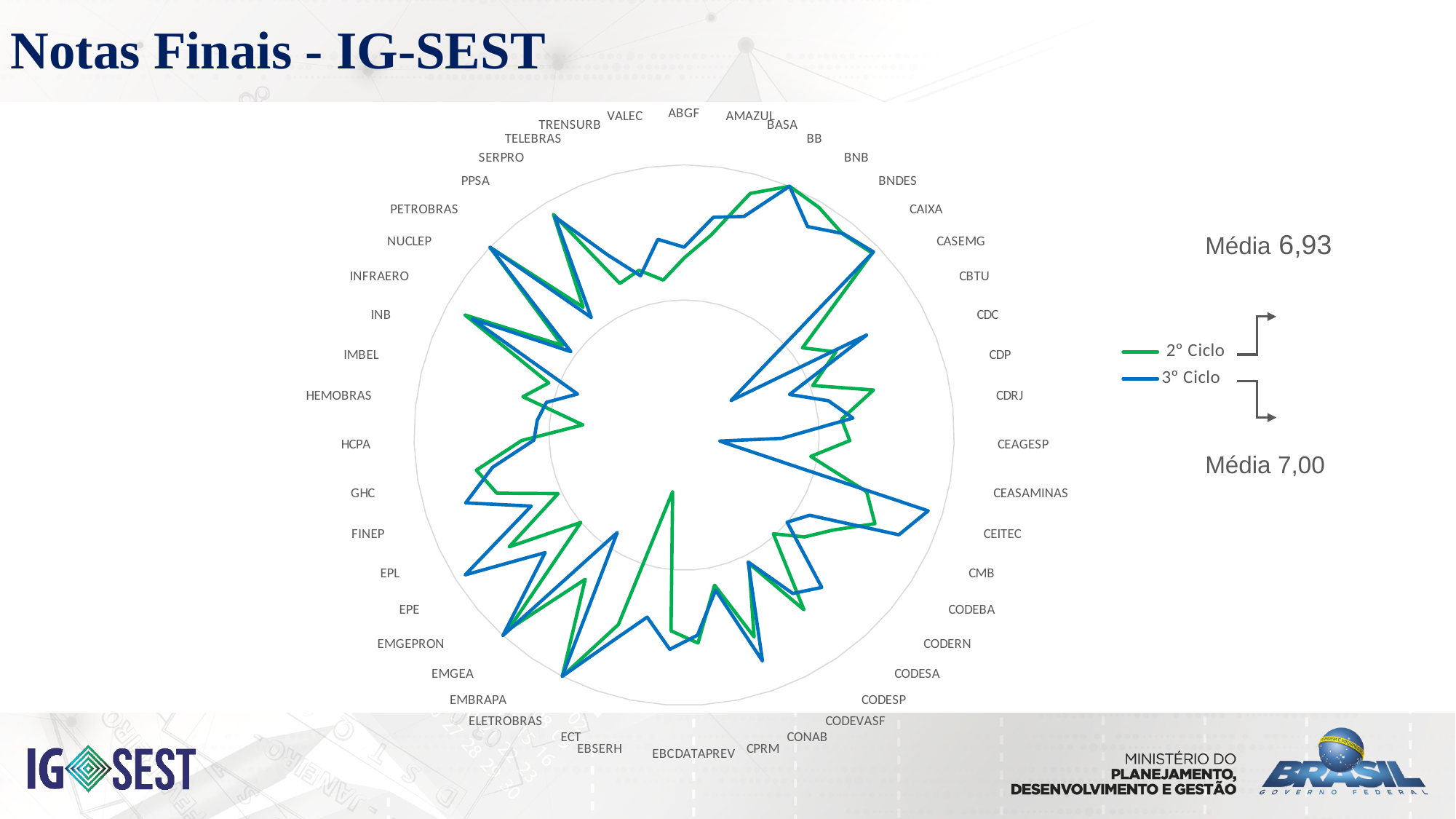
How many series does the legend of the chart list? 2 What average (Média) is shown for the 3° Ciclo series? 7,00 What kind of chart is shown on the slide? Radar chart For CBTU, which series has the larger value, 2° Ciclo or 3° Ciclo? 3° Ciclo What average (Média) is shown for the 2° Ciclo series? 6,93 What are the two series named in the chart legend? 2° Ciclo and 3° Ciclo What is the title of the slide containing the chart? Notas Finais - IG-SEST Which series has the higher average (Média), 2° Ciclo or 3° Ciclo? 3° Ciclo